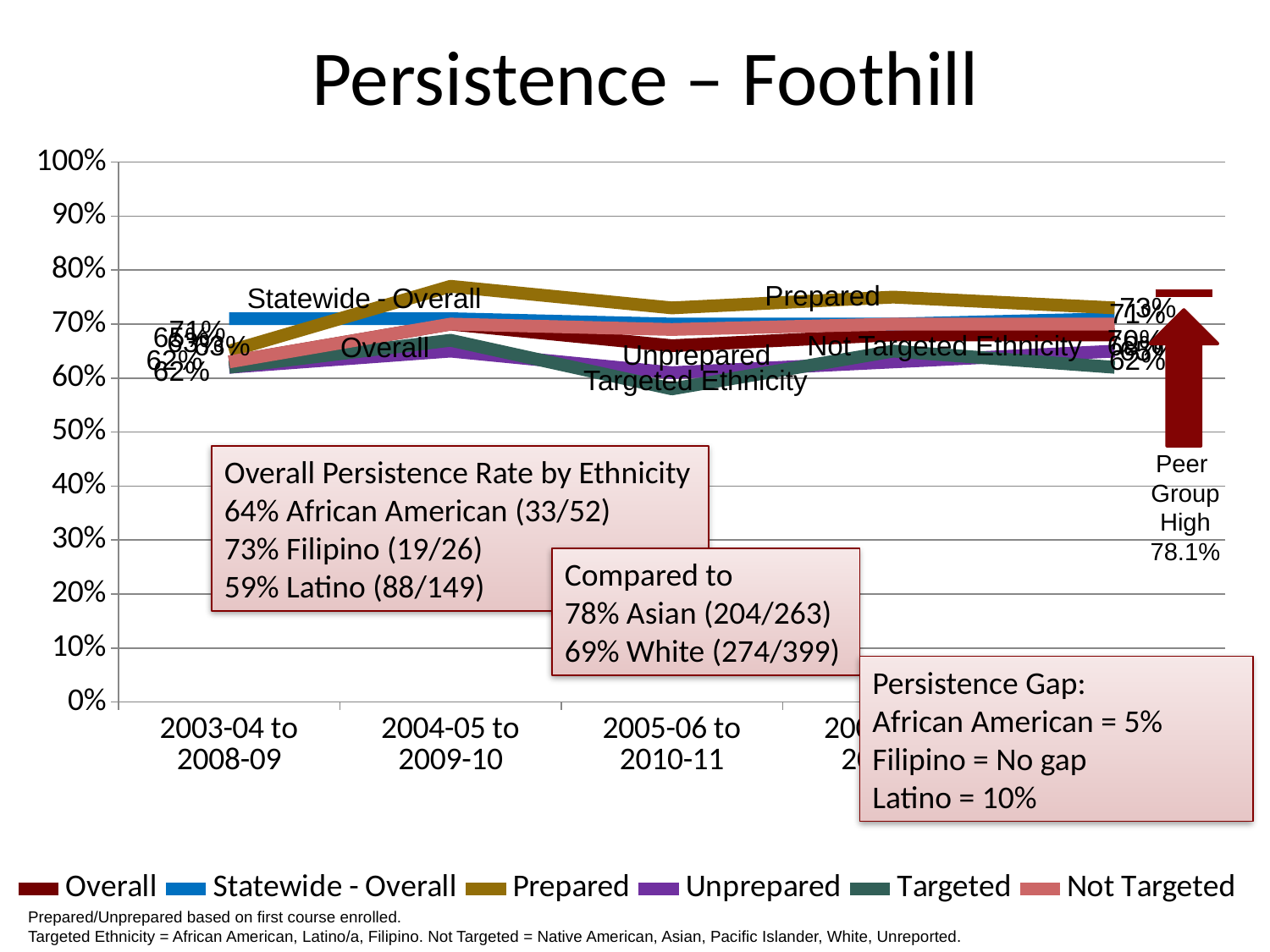
Which series is lowest at 2005-06 to 2010-11? Targeted What kind of chart is shown on the slide? line chart Is the value for Targeted at 2003-04 to 2008-09 greater or less than 70%? less What is the title of the chart? Persistence – Foothill How many series does the legend list? 6 Which series is highest at 2004-05 to 2009-10? Prepared Does the Prepared series rise or fall from 2003-04 to 2008-09 to 2004-05 to 2009-10? rise Which is larger at 2004-05 to 2009-10, Prepared or Targeted? Prepared Is the value for Prepared at 2004-05 to 2009-10 greater or less than 80%? less Which series is drawn in blue in the legend? Statewide - Overall What is the Peer Group High value shown next to the chart? 78.1% Is the value for Prepared at 2004-05 to 2009-10 greater or less than 70%? greater